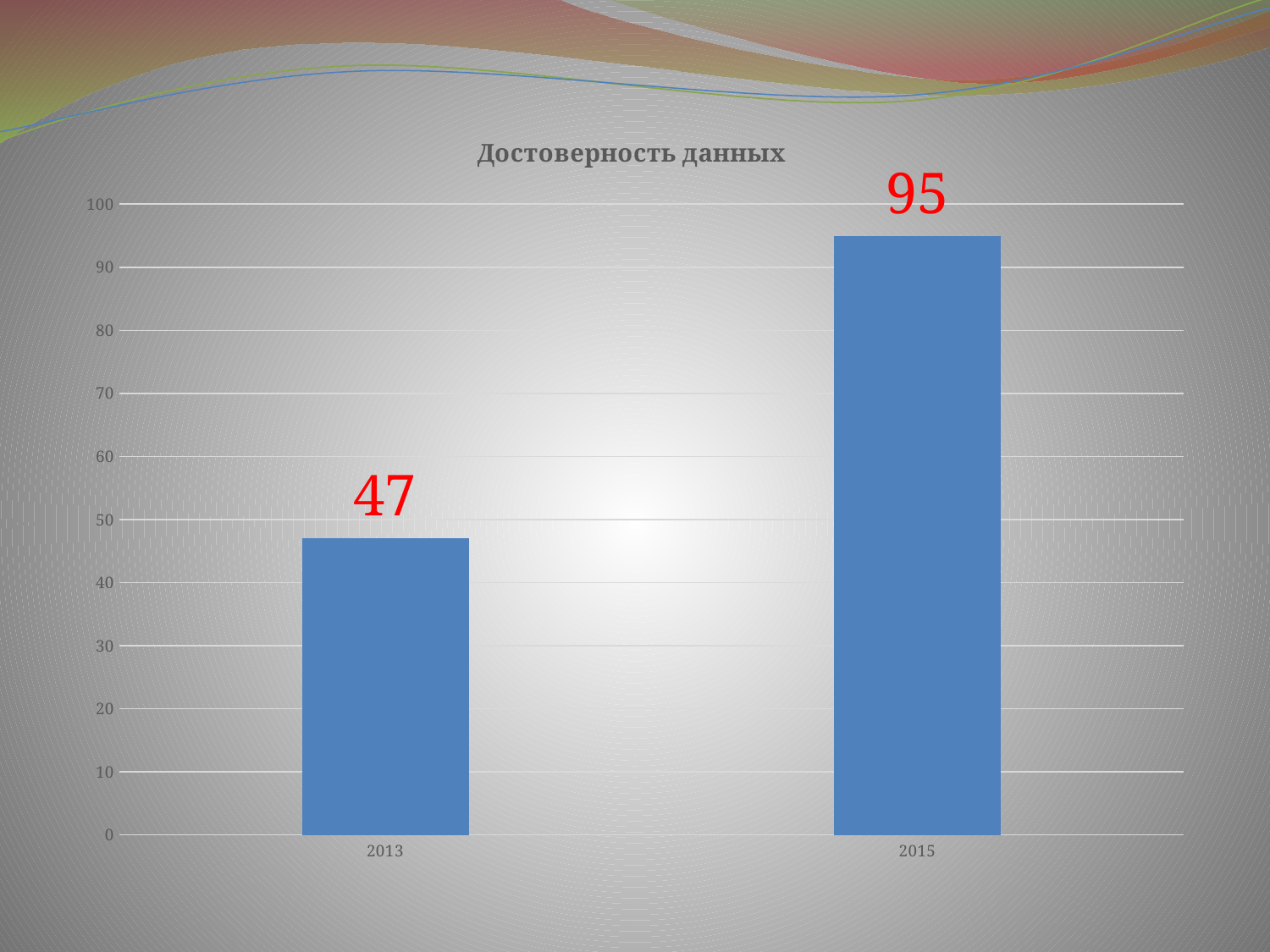
Which year has the lowest value? 2013 Is the value for 2015 greater or less than 90? greater What is the title of the chart? Достоверность данных How many categories are shown on the x axis? 2 Which is larger, the value for 2013 or the value for 2015? 2015 What is the difference between the values for 2015 and 2013? 48 What is the value for 2015? 95 Is the value for 2013 greater or less than 50? less Which year has the highest value? 2015 Do the values rise or fall from 2013 to 2015? rise What is the value for 2013? 47 What kind of chart is shown on the slide? bar chart